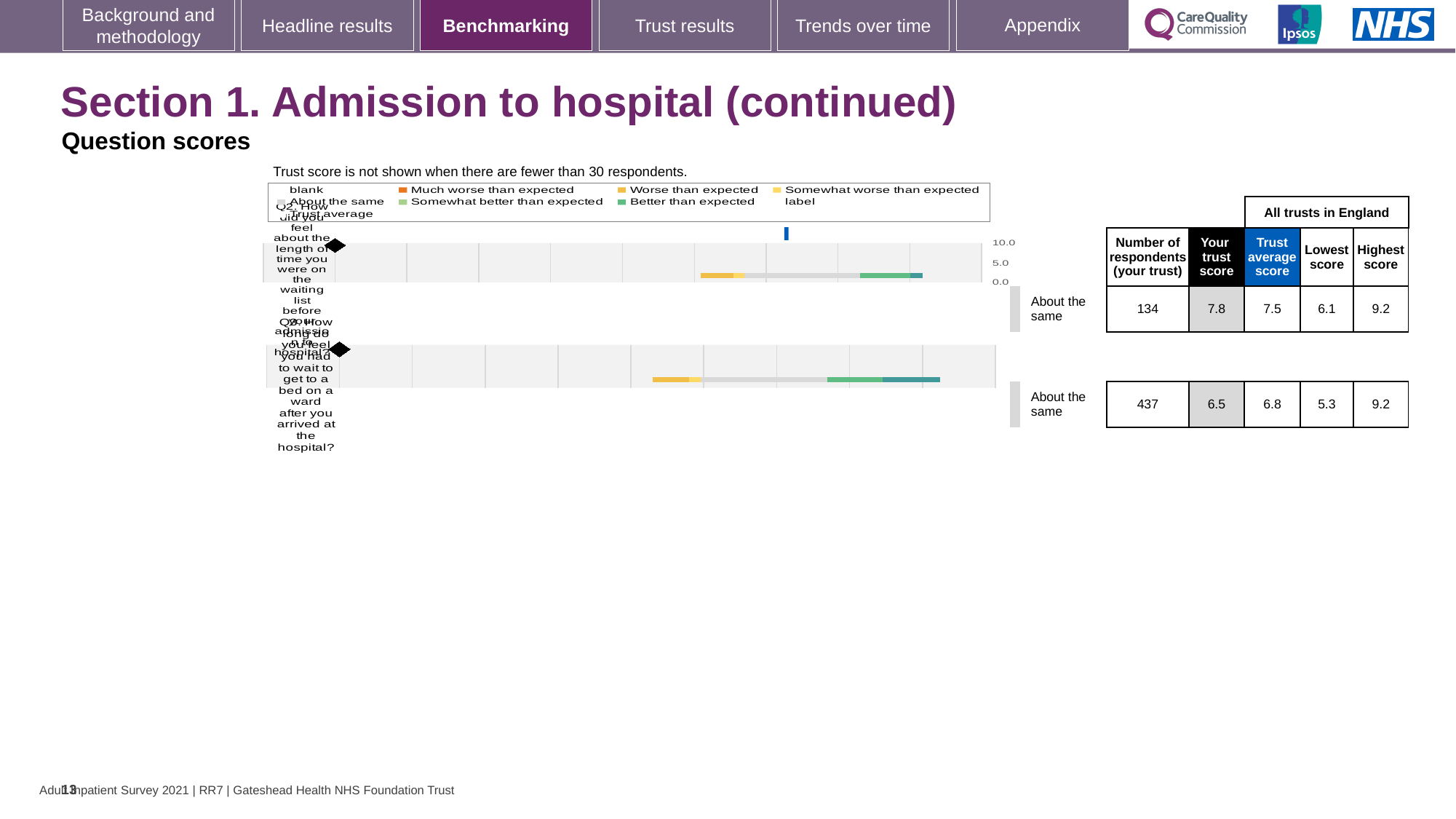
What kind of chart is used to show the question scores? Bar chart How many respondents from the trust answered Q3 (how long did you feel you had to wait to get to a bed on a ward)? 437 What is the trust score for Q2 (how did you feel about the length of time you were on the waiting list before admission)? 7.8 Which question had more respondents from the trust, Q2 or Q3? Q3 What is the difference between the highest and lowest scores for Q3? 3.9 Is the trust score for Q2 greater or less than 5.0 on the chart axis? greater How many questions are plotted on the slide? 2 For Q3, which is larger: the trust's own score or the trust average score? Trust average score What is the trust average score for all trusts in England for Q2? 7.5 What is the lowest score among all trusts in England for Q3? 5.3 What benchmark category is shown for the trust's Q3 score? About the same By how much does the trust's score for Q2 exceed the trust average score? 0.3